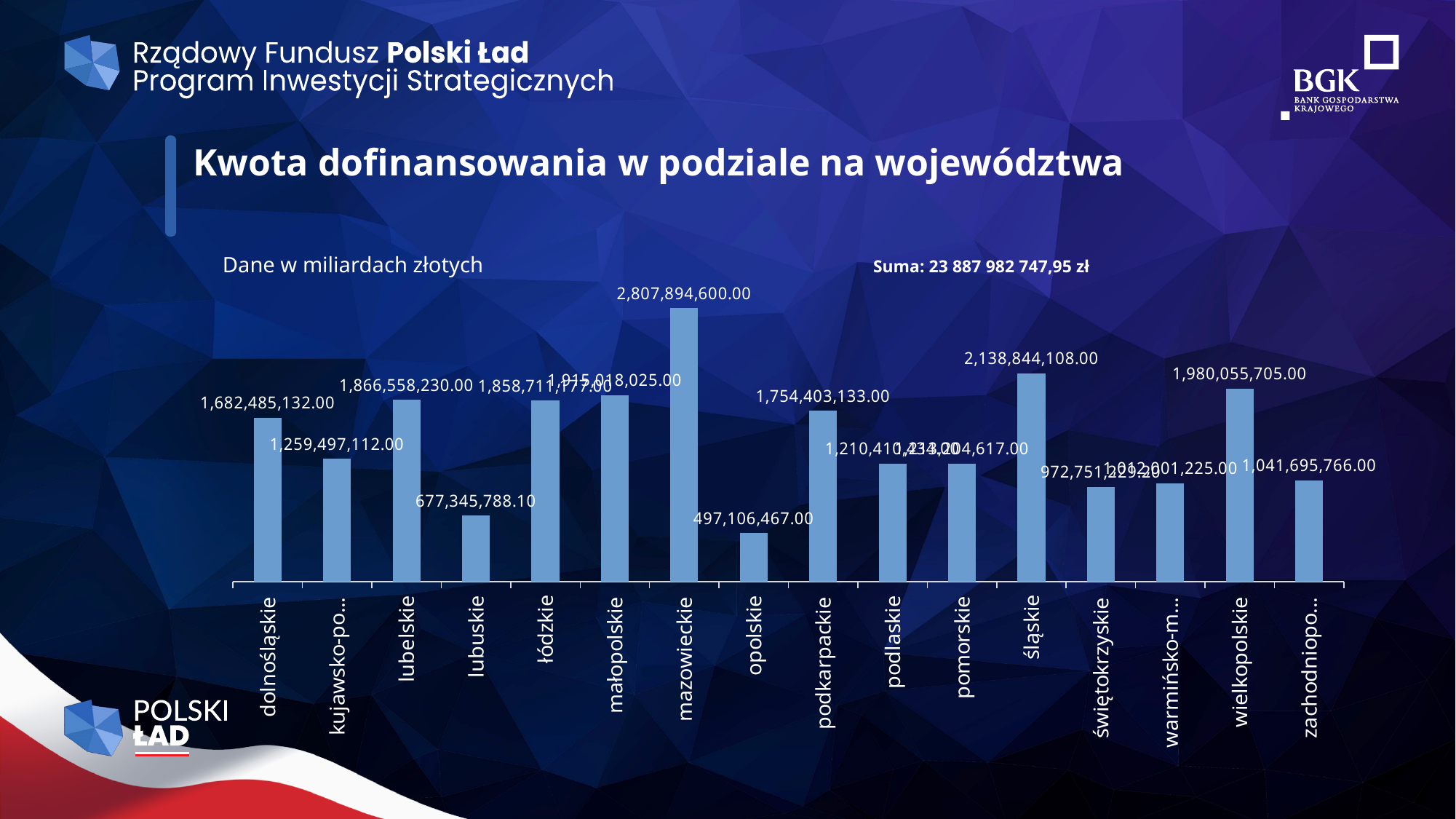
What is the value for lubuskie? 677,345,788.10 How many voivodeships (categories) are shown on the x axis? 16 What is the value for śląskie? 2,138,844,108.00 What is the value for mazowieckie? 2,807,894,600.00 Which has the larger value, śląskie or wielkopolskie? śląskie What is the difference between the values for mazowieckie and opolskie? 2,310,788,133.00 Which voivodeship has the lowest value? opolskie What type of chart is shown on the slide? bar chart What total sum (Suma) is printed on the slide? 23 887 982 747,95 zł What is the value for opolskie? 497,106,467.00 What is the title of the chart? Kwota dofinansowania w podziale na województwa Which voivodeship has the highest value? mazowieckie